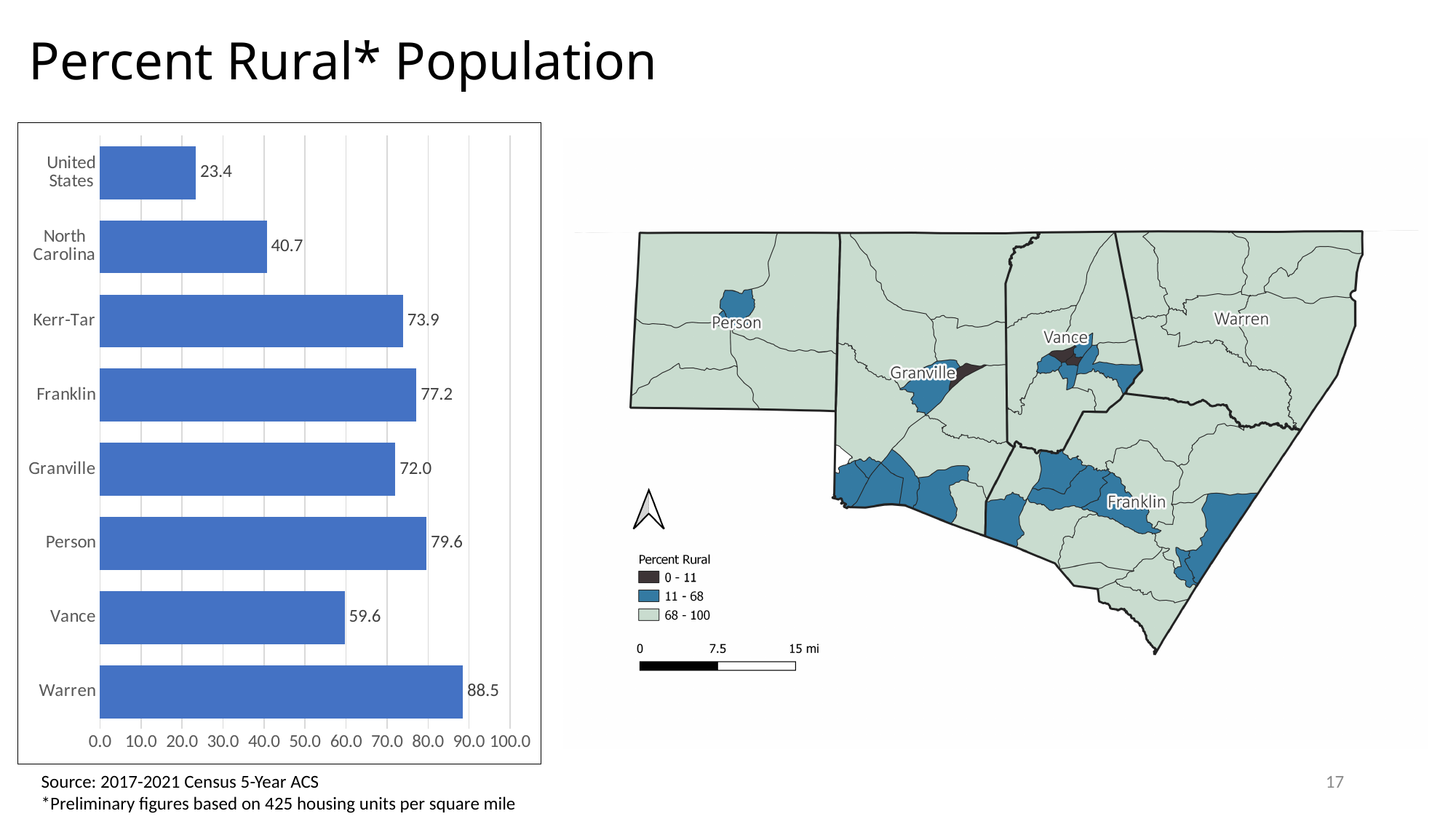
How many categories are shown in the bar chart? 8 What is the value for Kerr-Tar in the bar chart? 73.9 Is the value for North Carolina in the bar chart greater or less than 50.0? less What is the difference between the values for Person and Vance in the bar chart? 20.0 What value does the bar chart show for the United States? 23.4 Which category has the highest value in the bar chart? Warren What is the percent rural population value shown for Warren in the bar chart? 88.5 Which category has the lowest value in the bar chart? United States What is the difference between the values for Warren and North Carolina in the bar chart? 47.8 In the bar chart, which is larger, the value for Franklin or the value for Granville? Franklin What kind of chart is shown on the left of the slide? bar chart What is the title of the slide containing the bar chart? Percent Rural* Population